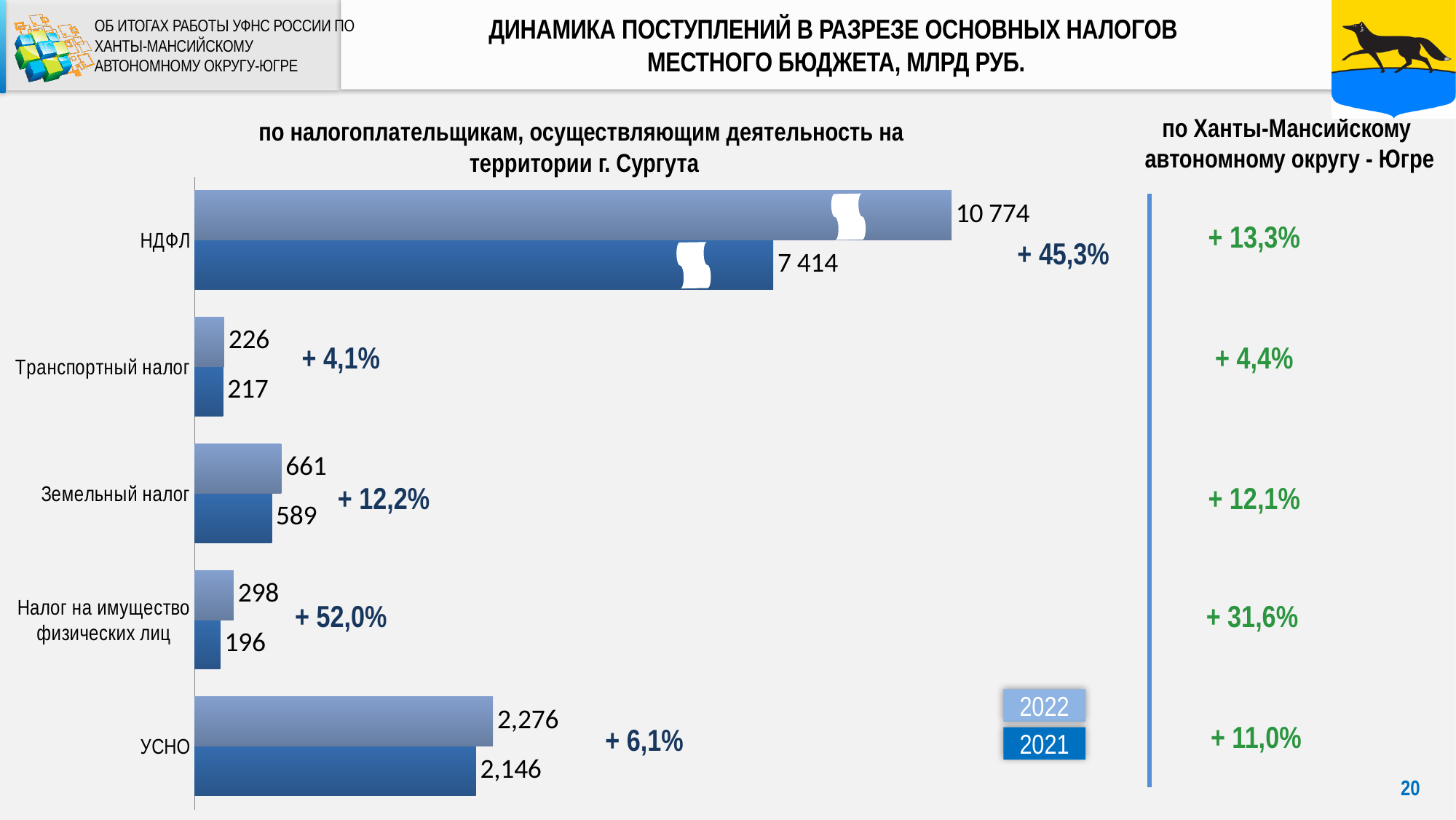
What is the difference between the 2022 and 2021 values for УСНО? 130 What is the difference between the 2022 and 2021 values for Транспортный налог? 9 Which tax category has the highest 2022 value? НДФЛ What is the 2022 value for НДФЛ? 10 774 Which is larger in 2022: Земельный налог or Налог на имущество физических лиц? Земельный налог What is the 2021 value for Земельный налог? 589 What kind of chart is shown on the slide? bar chart How many series does the legend list? 2 What growth percentage is shown for Налог на имущество физических лиц for taxpayers in Сургут? + 52,0% Which tax category has the lowest 2021 value? Налог на имущество физических лиц What growth percentage is shown for УСНО for Ханты-Мансийский автономный округ - Югра? + 11,0% How many tax categories are shown in the chart? 5